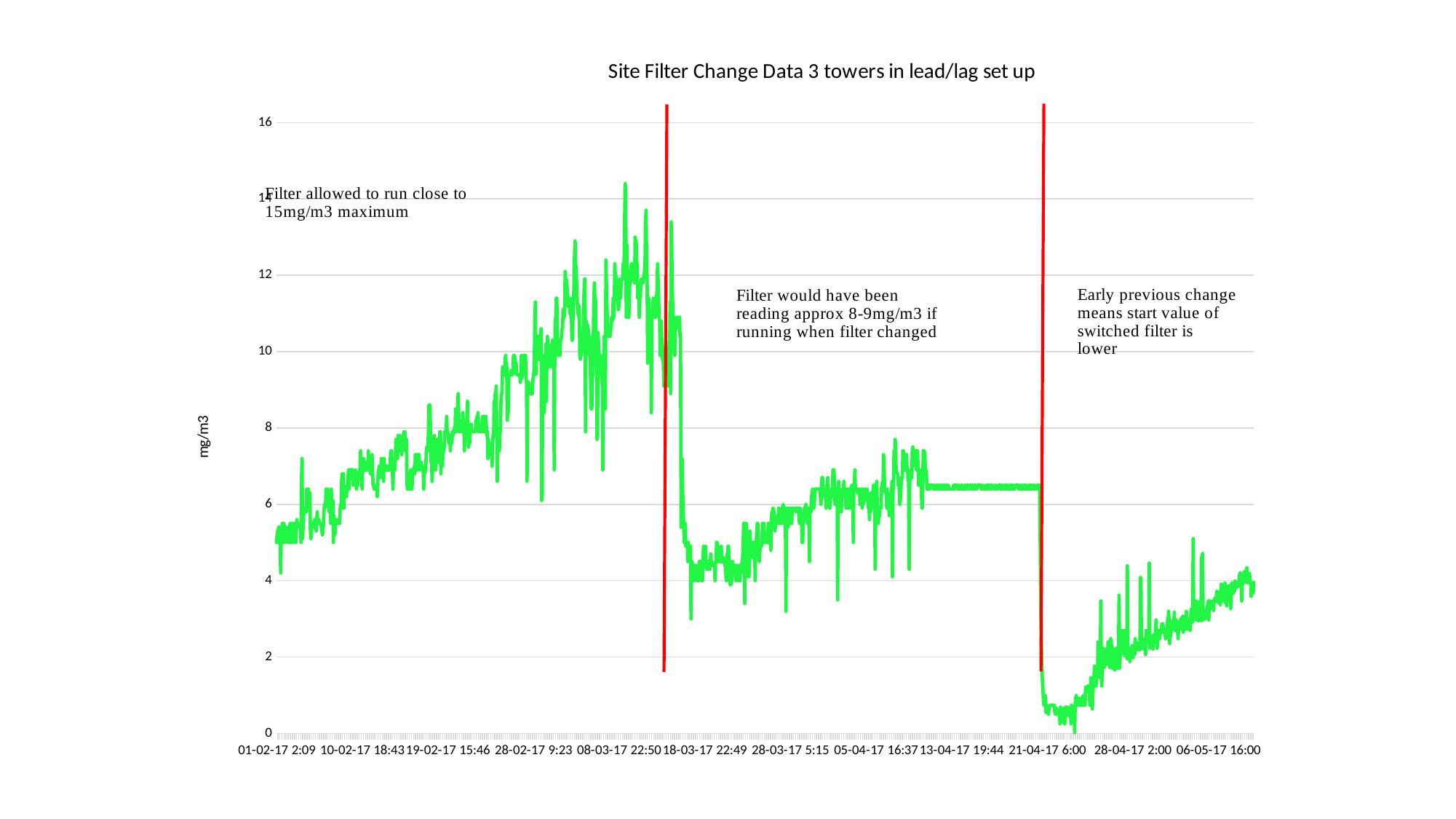
Is the flat section of the series just before the second red vertical line greater or less than 6? greater Is the highest peak of the series greater or less than 14? greater Is the value immediately after the second red vertical line (around 21-04-17 6:00) greater or less than 2? less What kind of chart is shown on the slide? line chart What is the title of the chart? Site Filter Change Data 3 towers in lead/lag set up Does the series generally rise or fall between 01-02-17 2:09 and 08-03-17 22:50? rise What is the label on the vertical axis of the chart? mg/m3 What is the highest tick value shown on the vertical axis? 16 Does the series generally rise or fall between 21-04-17 6:00 and 06-05-17 16:00? rise